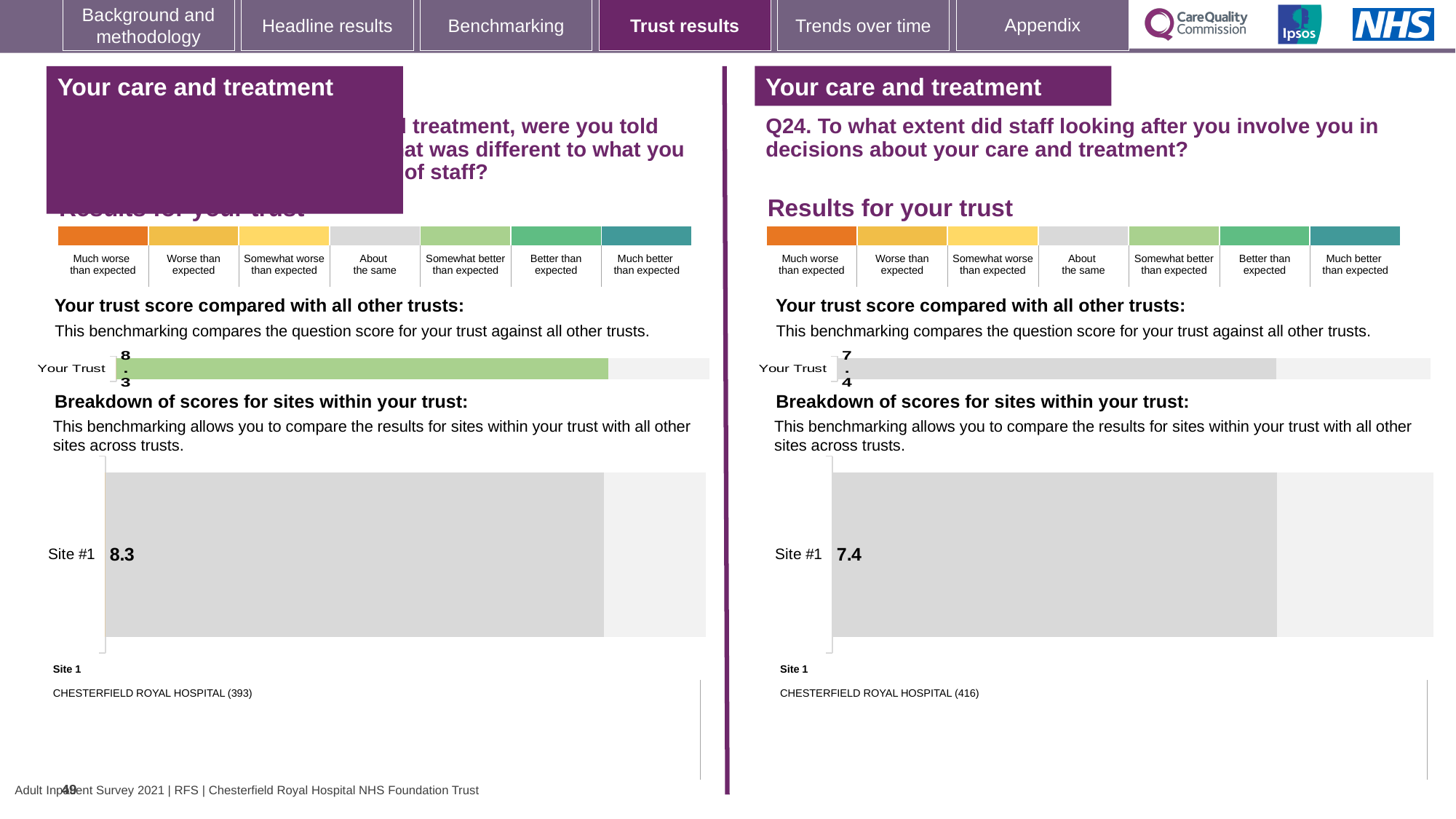
What is the difference between the Site #1 score on the left half of the slide and the Site #1 score on the right half (Q24)? 0.9 What type of chart is used to show the 'Your Trust' score on the left half of the slide? Bar chart On the left half of the slide, what colour is the 'Your Trust' bar? Green How many sites are shown in the right-hand 'Breakdown of scores for sites within your trust' chart (Q24)? 1 In the left-hand 'Breakdown of scores for sites within your trust' chart, what is the score for Site #1? 8.3 What type of chart is used for the 'Breakdown of scores for sites within your trust' on the right half of the slide (Q24)? Bar chart How many sites are shown in the left-hand 'Breakdown of scores for sites within your trust' chart? 1 On the left half of the slide, what is the 'Your Trust' score shown in the trust benchmarking bar? 8.3 In the right-hand 'Breakdown of scores for sites within your trust' chart (Q24), what is the score for Site #1? 7.4 On the right half of the slide (Q24), what colour is the 'Your Trust' bar? Grey On the right half of the slide (Q24), what is the 'Your Trust' score shown in the trust benchmarking bar? 7.4 Which is larger: the 'Your Trust' score on the left half of the slide or the 'Your Trust' score on the right half (Q24)? Left half (8.3)